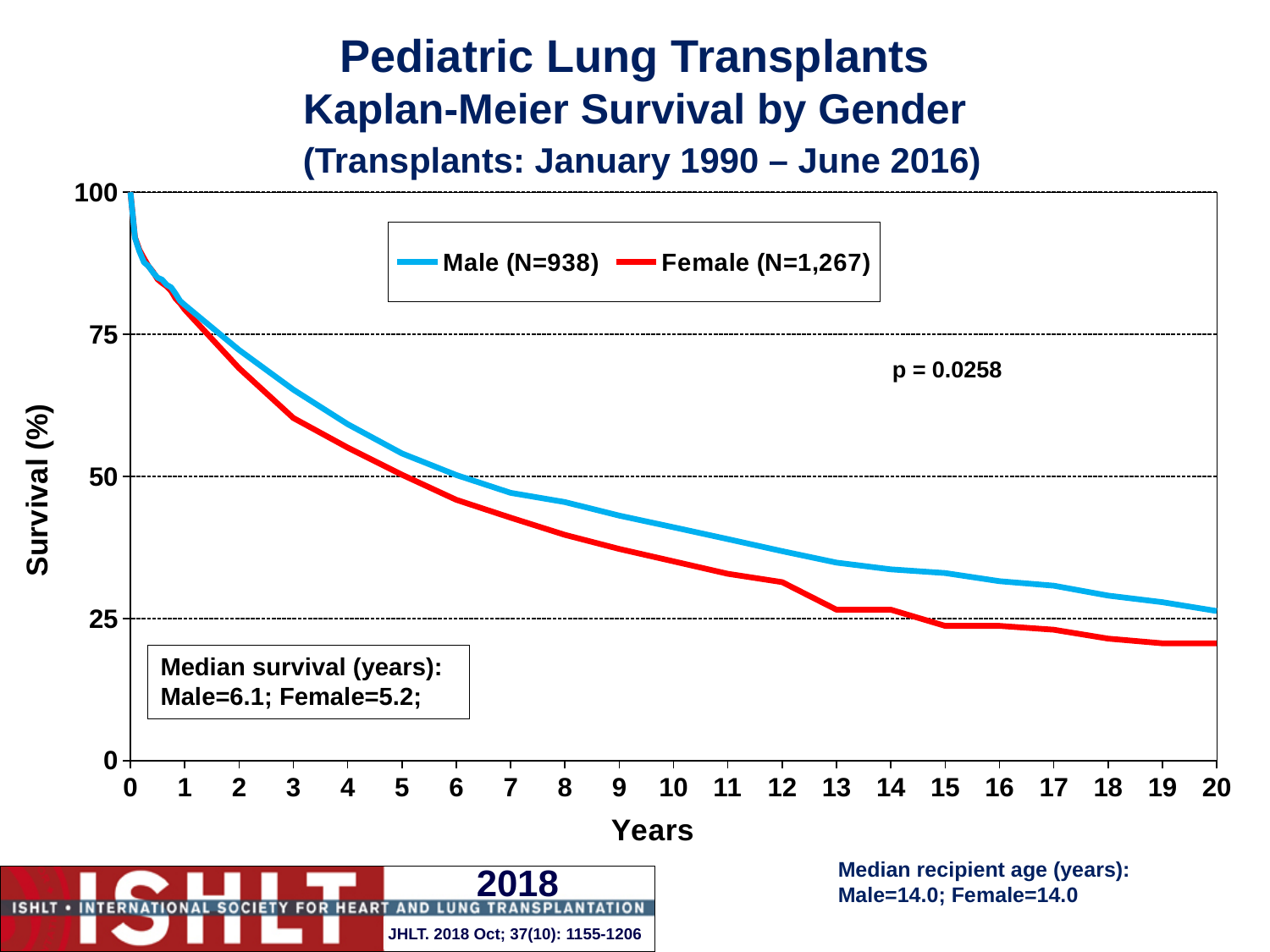
What is the median survival in years for males? 6.1 What is the number of patients (N) in the Male group? 938 Which colour is used for the Female curve? red What kind of chart is shown on the slide? line chart Is the Female survival at 20 years greater or less than 25? less What is the median survival in years for females? 5.2 Do the survival curves rise or fall as years increase along the x axis? fall How many series does the legend list? 2 Is the Male survival at 10 years greater or less than 50? less What is the p-value shown on the chart? p = 0.0258 What is the number of patients (N) in the Female group? 1,267 At 10 years, which group has the higher survival, Male or Female? Male